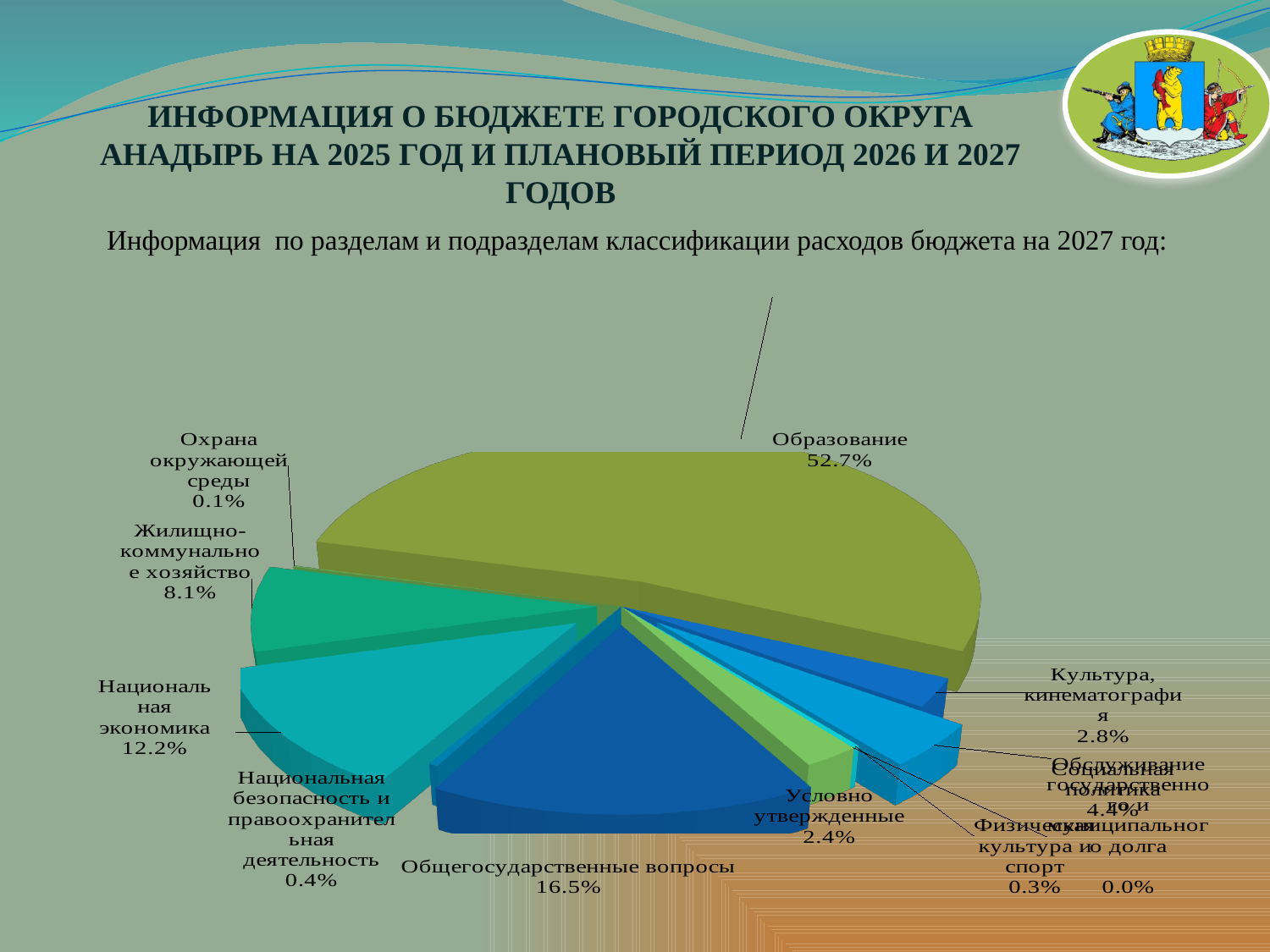
What is the difference in percentage points between Национальная экономика and Жилищно-коммунальное хозяйство? 4.1% For which year does the chart show the breakdown of budget expenditures by section? 2027 What percentage is shown for Общегосударственные вопросы? 16.5% What share of the 2027 budget expenditures goes to Образование? 52.7% Which category has the largest share of the pie? Образование Which is larger: the share for Национальная экономика or for Жилищно-коммунальное хозяйство? Национальная экономика What kind of chart is shown on the slide? pie chart What is the difference in percentage points between Образование and Общегосударственные вопросы? 36.2% What percentage is shown for Культура, кинематография? 2.8% What percentage is shown for Жилищно-коммунальное хозяйство? 8.1% What percentage is shown for Национальная экономика? 12.2% What percentage is shown for Условно утвержденные? 2.4%